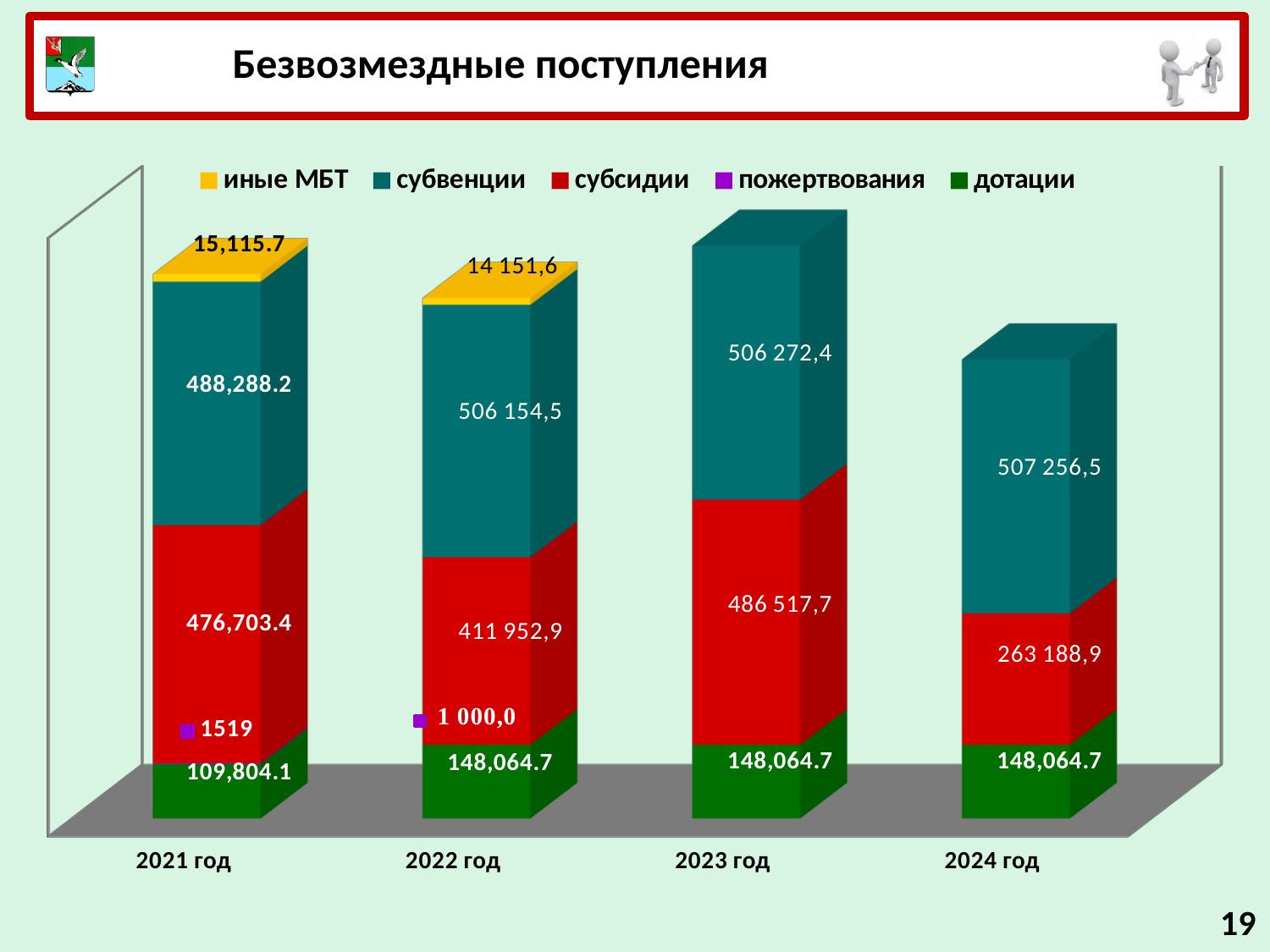
Which is larger: субсидии in 2021 год or субсидии in 2022 год? 2021 год What is the value of пожертвования for 2021 год? 1519 What is the value of дотации for 2023 год? 148,064.7 How many series does the legend list? 5 In which year is the value of субсидии the highest? 2023 год What kind of chart is shown on the slide? Stacked bar chart What is the value of субвенции for 2021 год? 488,288.2 What is the value of субсидии for 2022 год? 411 952,9 What is the value of иные МБТ for 2022 год? 14 151,6 What is the difference between субсидии in 2023 год and 2024 год? 223 328,8 In which year is the value of субсидии the lowest? 2024 год How many years are shown on the x axis? 4